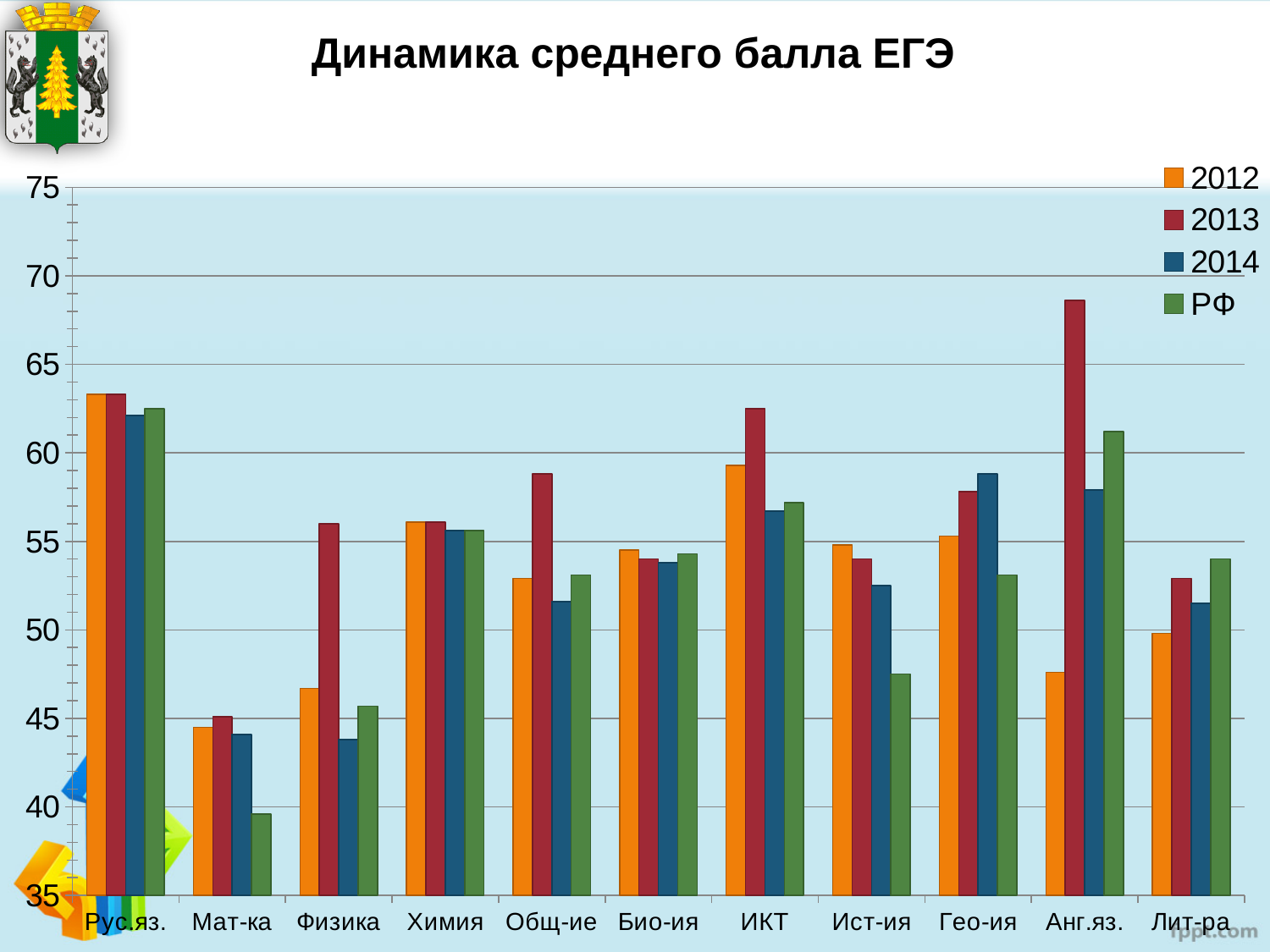
Which subject has the highest value for the 2012 series? Рус.яз. What is the title of the chart? Динамика среднего балла ЕГЭ How many series does the legend list? 4 Is the 2014 value for Физика greater or less than 45? less Which subject has the lowest value for the РФ series? Мат-ка How many subject categories are shown on the x axis? 11 What kind of chart is shown on the slide? bar chart Which subject has the highest value for the 2013 series? Анг.яз. Is the РФ value for Мат-ка greater or less than 40? less For Физика, which is larger: the 2013 value or the 2014 value? 2013 For Гео-ия, which is larger: the 2014 value or the РФ value? 2014 Is the 2013 value for Анг.яз. greater or less than 65? greater